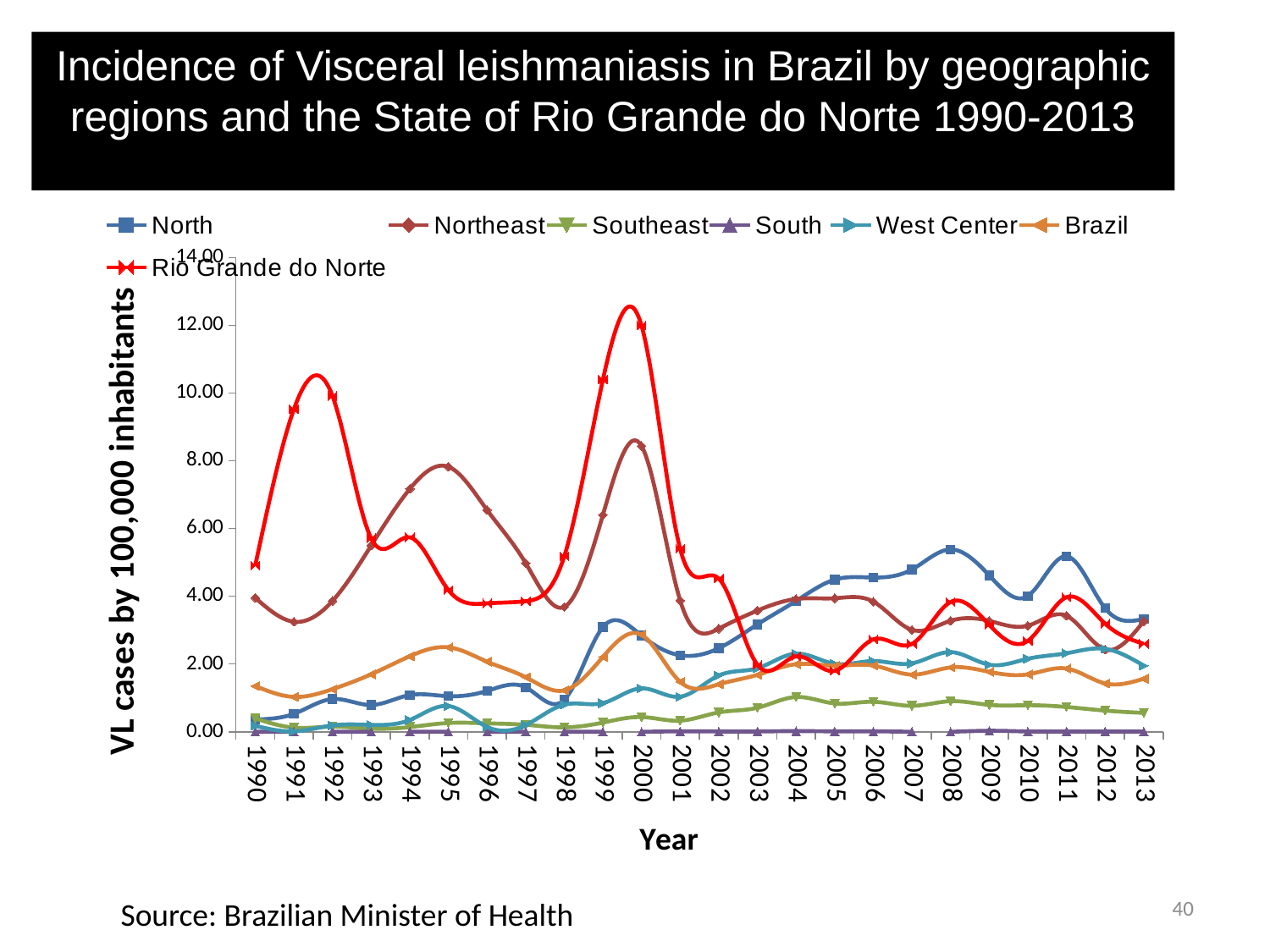
In 2013, which is larger: the value for North or the value for Brazil? North Is the value for North in 2008 greater or less than 4.00? greater Is the value for Northeast in 2000 greater or less than 6.00? greater How many series does the legend list? 7 Is the value for Southeast in 2004 greater or less than 2.00? less How many years are plotted along the x axis? 24 What is the title of the y axis? VL cases by 100,000 inhabitants Which series reaches the highest value on the chart? Rio Grande do Norte Which series stays lowest across the whole period? South What kind of chart is shown on the slide? line chart In 2000, which is larger: the value for Rio Grande do Norte or the value for Northeast? Rio Grande do Norte